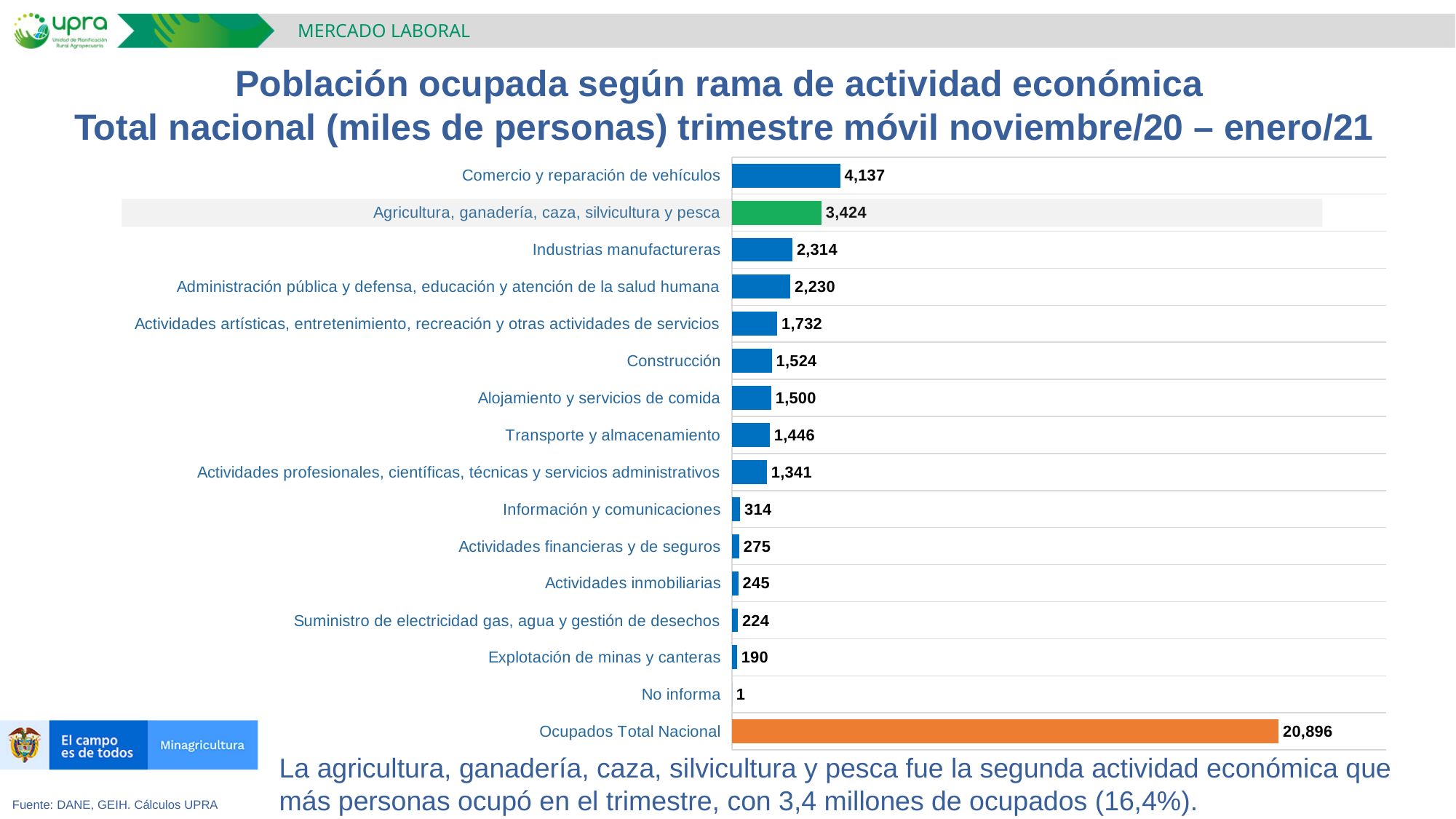
What colour is the bar for Agricultura, ganadería, caza, silvicultura y pesca? Green Which is larger, Construcción or Alojamiento y servicios de comida? Construcción What kind of chart is shown on the slide? Bar chart What is the value for Comercio y reparación de vehículos? 4,137 What is the difference between Comercio y reparación de vehículos and Agricultura, ganadería, caza, silvicultura y pesca? 713 What is the value for Ocupados Total Nacional? 20,896 Which category has the lowest value? No informa What is the value for Explotación de minas y canteras? 190 What is the value for Agricultura, ganadería, caza, silvicultura y pesca? 3,424 Excluding the Ocupados Total Nacional bar, which activity has the highest value? Comercio y reparación de vehículos How many bars are plotted in the chart, including Ocupados Total Nacional? 16 What is the difference between Industrias manufactureras and Administración pública y defensa, educación y atención de la salud humana? 84